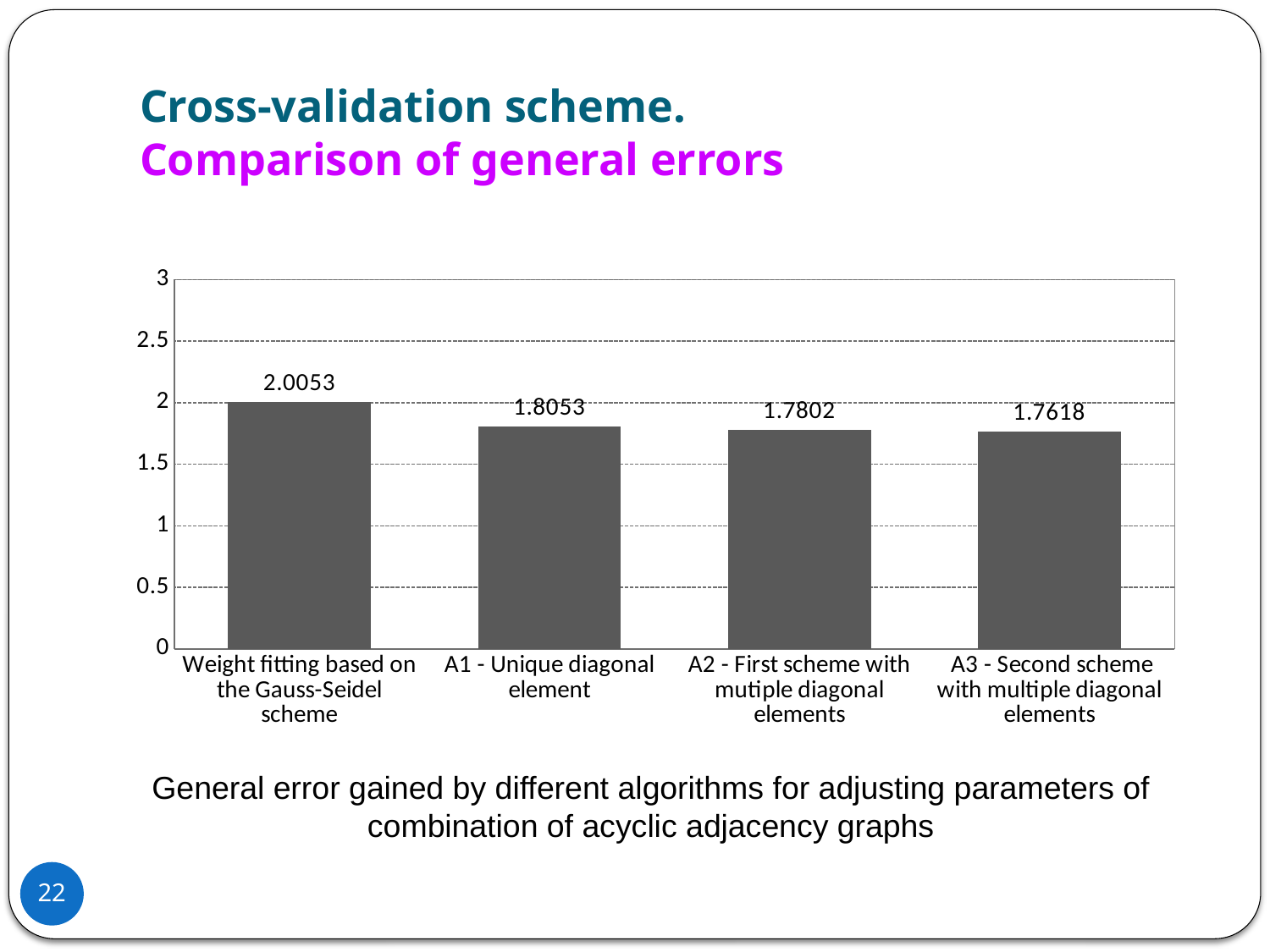
Which category has the highest general error? Weight fitting based on the Gauss-Seidel scheme What kind of chart is shown on the slide? bar chart Is the value for Weight fitting based on the Gauss-Seidel scheme greater or less than 2.5? less What is the difference between the values for Weight fitting based on the Gauss-Seidel scheme and A1 - Unique diagonal element? 0.2 How many categories are shown in the chart? 4 Which category has the lowest general error? A3 - Second scheme with multiple diagonal elements What is the value shown for A1 - Unique diagonal element? 1.8053 What is the difference between the values for A2 - First scheme with mutiple diagonal elements and A3 - Second scheme with multiple diagonal elements? 0.0184 What is the value shown for A3 - Second scheme with multiple diagonal elements? 1.7618 What is the general error for Weight fitting based on the Gauss-Seidel scheme? 2.0053 What is the value shown for A2 - First scheme with mutiple diagonal elements? 1.7802 Which is larger, the value for A1 - Unique diagonal element or the value for A3 - Second scheme with multiple diagonal elements? A1 - Unique diagonal element